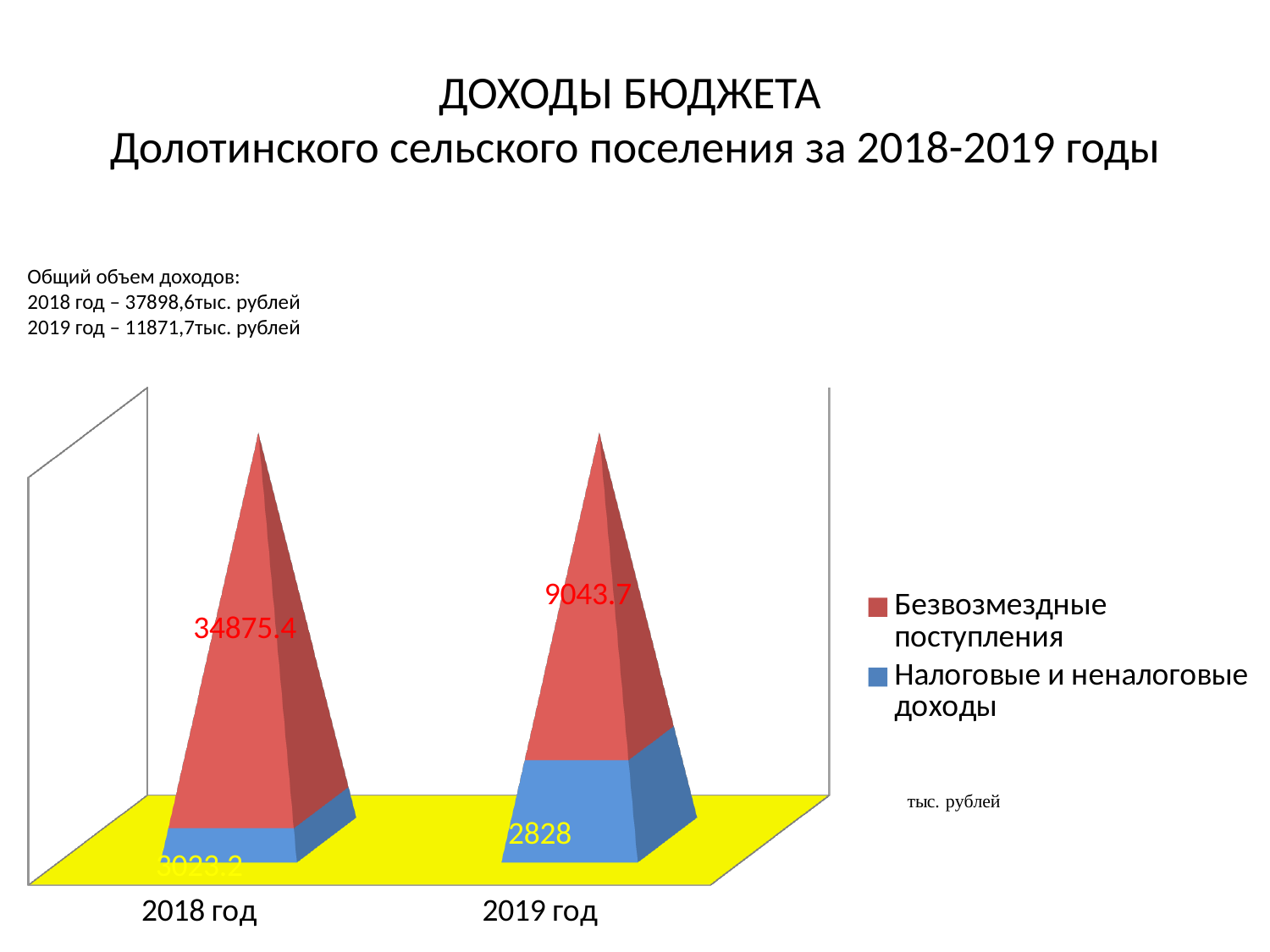
What is the value of Налоговые и неналоговые доходы for 2019 год? 2828 Which year has the higher value of Безвозмездные поступления? 2018 год What is the value of Безвозмездные поступления for 2019 год? 9043.7 How many categories are shown on the x axis? 2 How many series does the legend list? 2 What is the value of Безвозмездные поступления for 2018 год? 34875.4 What is the total of the stacked bar for 2019 год? 11871.7 Which year has the lower value of Налоговые и неналоговые доходы? 2019 год What is the value of Налоговые и неналоговые доходы for 2018 год? 3023.2 What is the difference between Безвозмездные поступления in 2018 год and 2019 год? 25831.7 What is the total of the stacked bar for 2018 год? 37898.6 What kind of chart is shown on the slide? Stacked bar chart